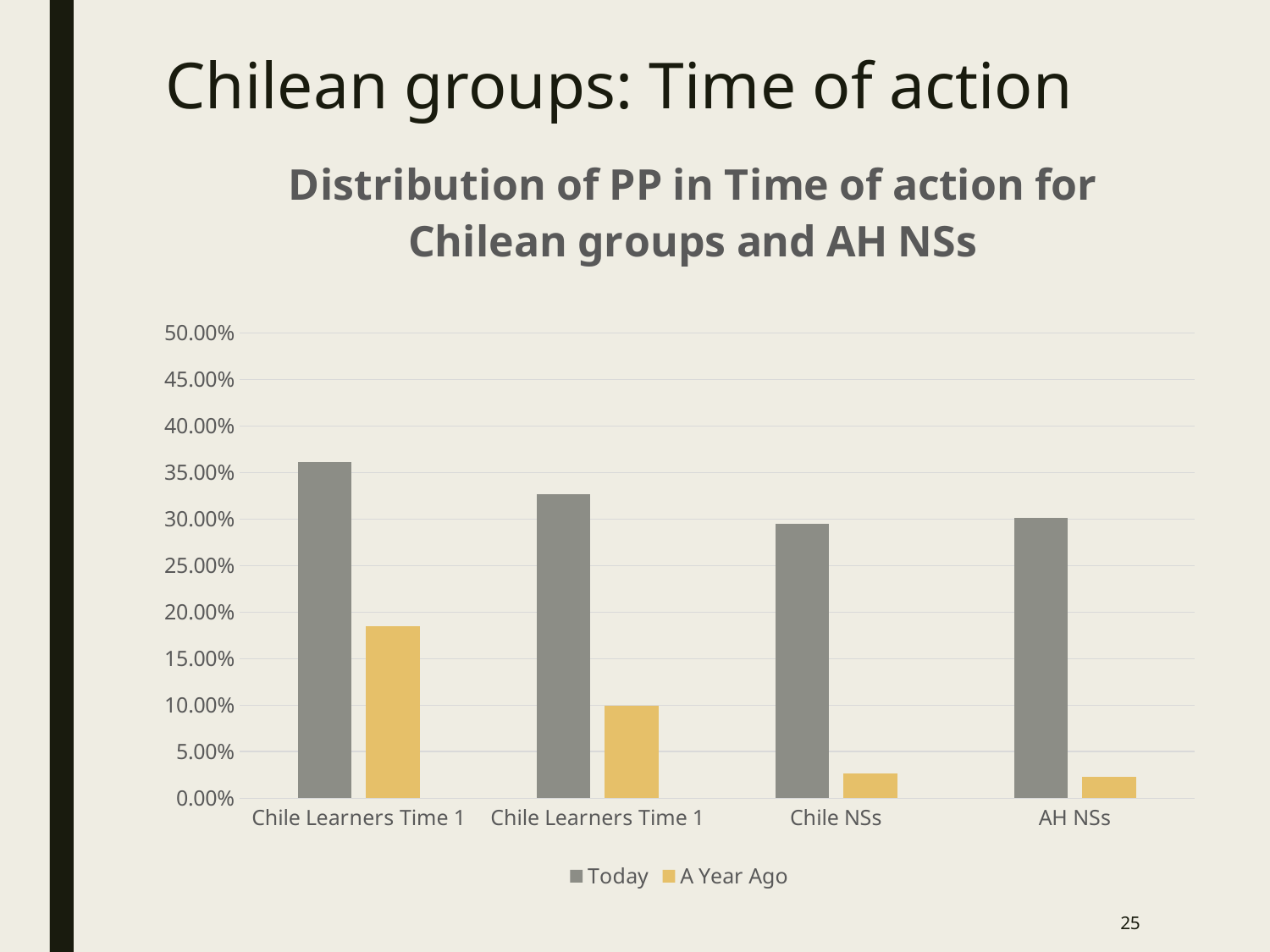
How many series does the legend list? 2 Which category group has the highest Today value? the leftmost Chile Learners Time 1 group Which series is shown in yellow in the legend? A Year Ago Which category group has the highest A Year Ago value? the leftmost Chile Learners Time 1 group For AH NSs, which is larger: the Today value or the A Year Ago value? Today How many category groups are shown along the x axis? 4 Is the Today value for Chile NSs greater or less than 25.00%? greater What kind of chart is shown on the slide? bar chart Is the Today value for AH NSs greater or less than 25.00%? greater What is the title of the chart? Distribution of PP in Time of action for Chilean groups and AH NSs Is the A Year Ago value for AH NSs greater or less than 5.00%? less